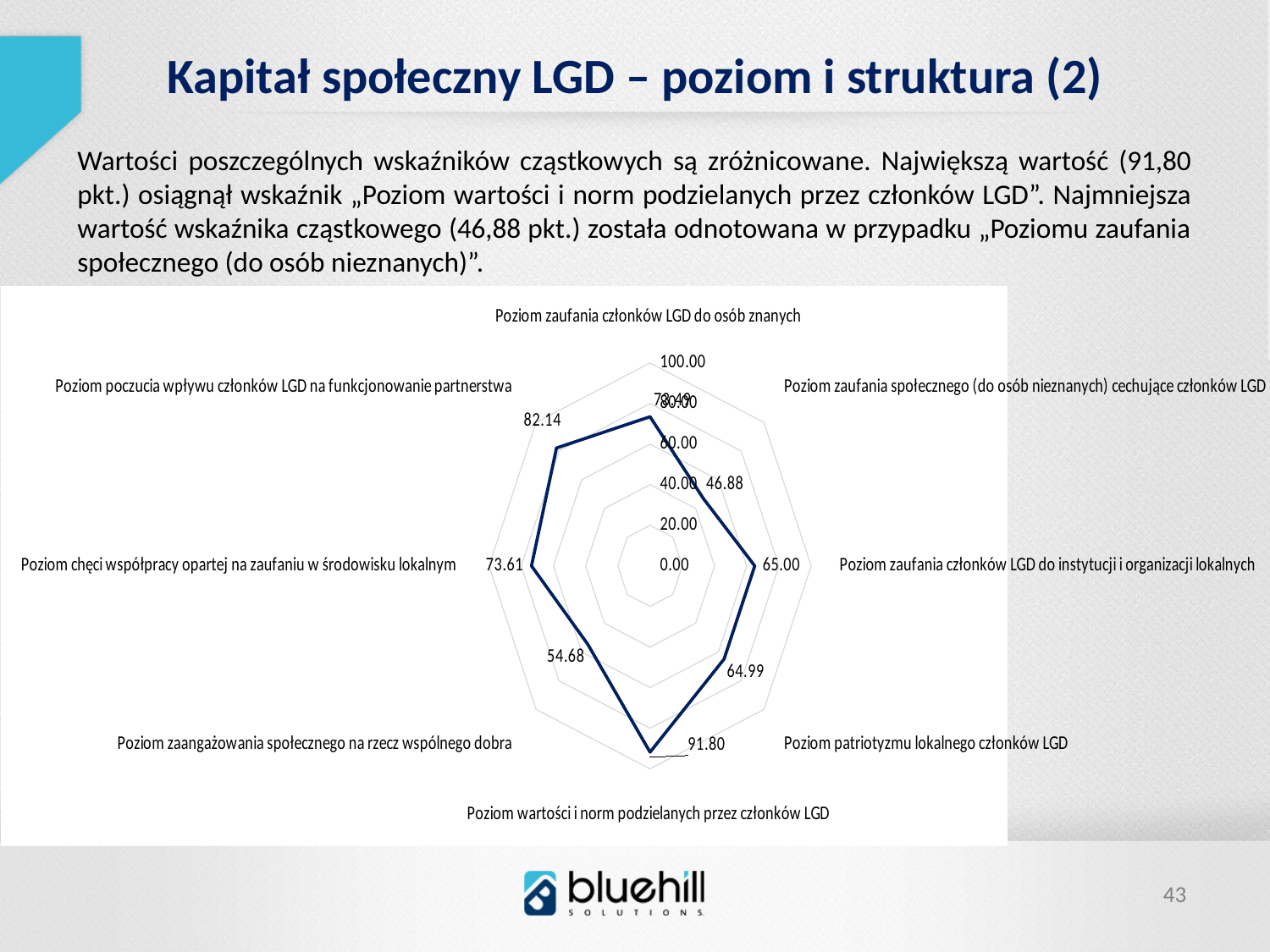
How many categories (indicators) are plotted on the radar chart? 8 What type of chart is shown on the slide? Radar chart Which indicator has the highest value on the radar chart? Poziom wartości i norm podzielanych przez członków LGD What is the value for "Poziom zaufania społecznego (do osób nieznanych) cechujące członków LGD"? 46.88 Which indicator has the lowest value on the radar chart? Poziom zaufania społecznego (do osób nieznanych) cechujące członków LGD What is the value for "Poziom chęci współpracy opartej na zaufaniu w środowisku lokalnym"? 73.61 Which is larger: the value for "Poziom poczucia wpływu członków LGD na funkcjonowanie partnerstwa" or for "Poziom zaangażowania społecznego na rzecz wspólnego dobra"? Poziom poczucia wpływu członków LGD na funkcjonowanie partnerstwa What is the difference between the highest value (91.80) and the lowest value (46.88) on the chart? 44.92 Is the value for "Poziom zaufania członków LGD do osób znanych" greater or less than 60.00? greater What is the value for "Poziom poczucia wpływu członków LGD na funkcjonowanie partnerstwa"? 82.14 What is the value for "Poziom zaangażowania społecznego na rzecz wspólnego dobra"? 54.68 What is the value for "Poziom wartości i norm podzielanych przez członków LGD"? 91.80